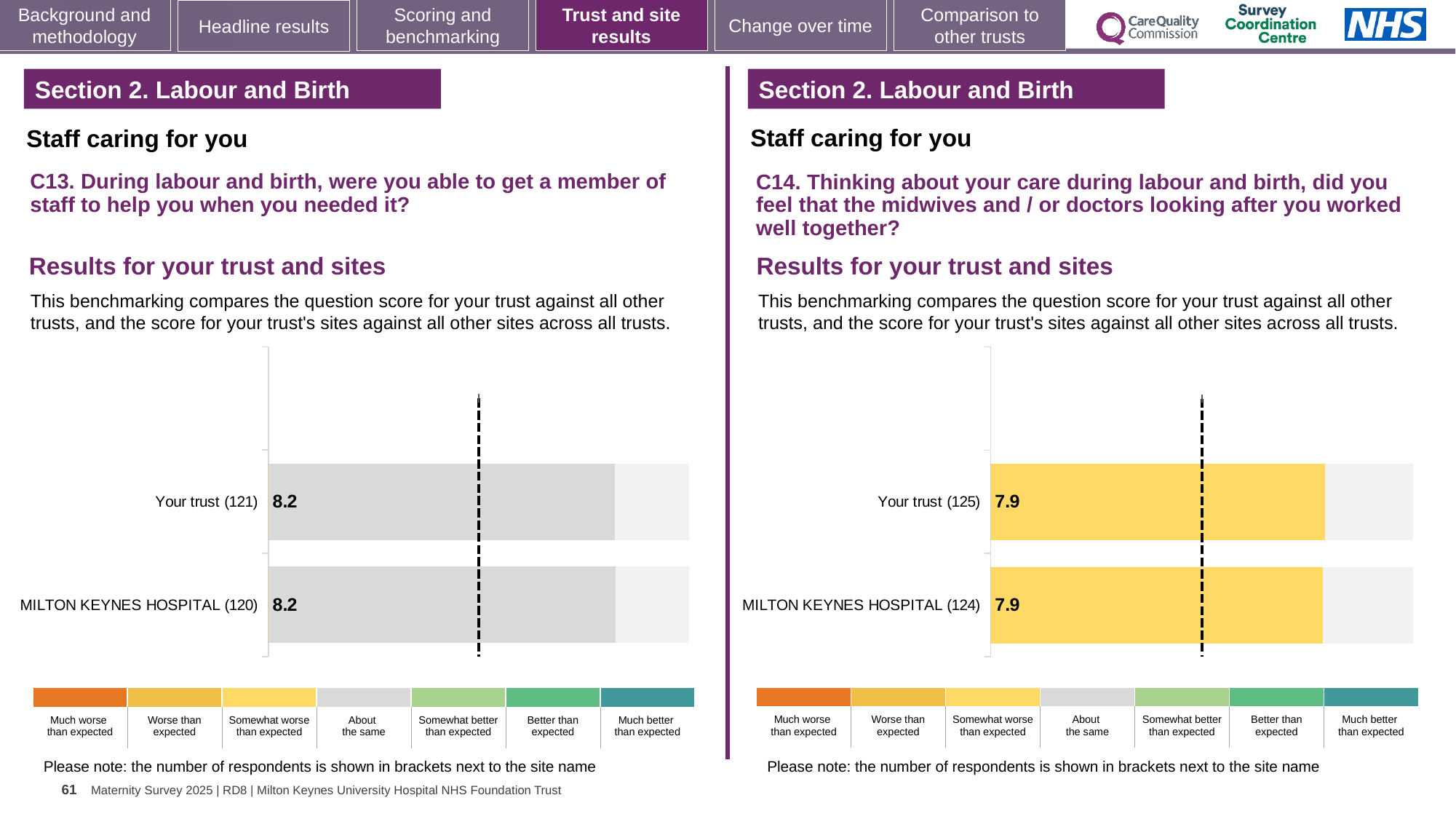
In the C13 chart on the left, what is the score for Your trust? 8.2 In the C14 chart on the right, how many respondents are shown in brackets for MILTON KEYNES HOSPITAL? 124 In the C14 chart on the right, what is the score for MILTON KEYNES HOSPITAL? 7.9 In the C14 chart on the right, what is the score for Your trust? 7.9 How many bars are plotted in the C13 chart on the left? 2 In the C13 chart on the left, what is the difference between the score for Your trust and the score for MILTON KEYNES HOSPITAL? 0.0 How many bars are plotted in the C14 chart on the right? 2 What kind of chart is used for the C13 results on the left? Bar chart According to the colour key, which benchmarking category do the yellow bars in the C14 chart on the right represent? Somewhat worse than expected In the C14 chart on the right, what is the difference between the score for Your trust and the score for MILTON KEYNES HOSPITAL? 0.0 In the C13 chart on the left, what is the score for MILTON KEYNES HOSPITAL? 8.2 In the C13 chart on the left, how many respondents are shown in brackets for Your trust? 121